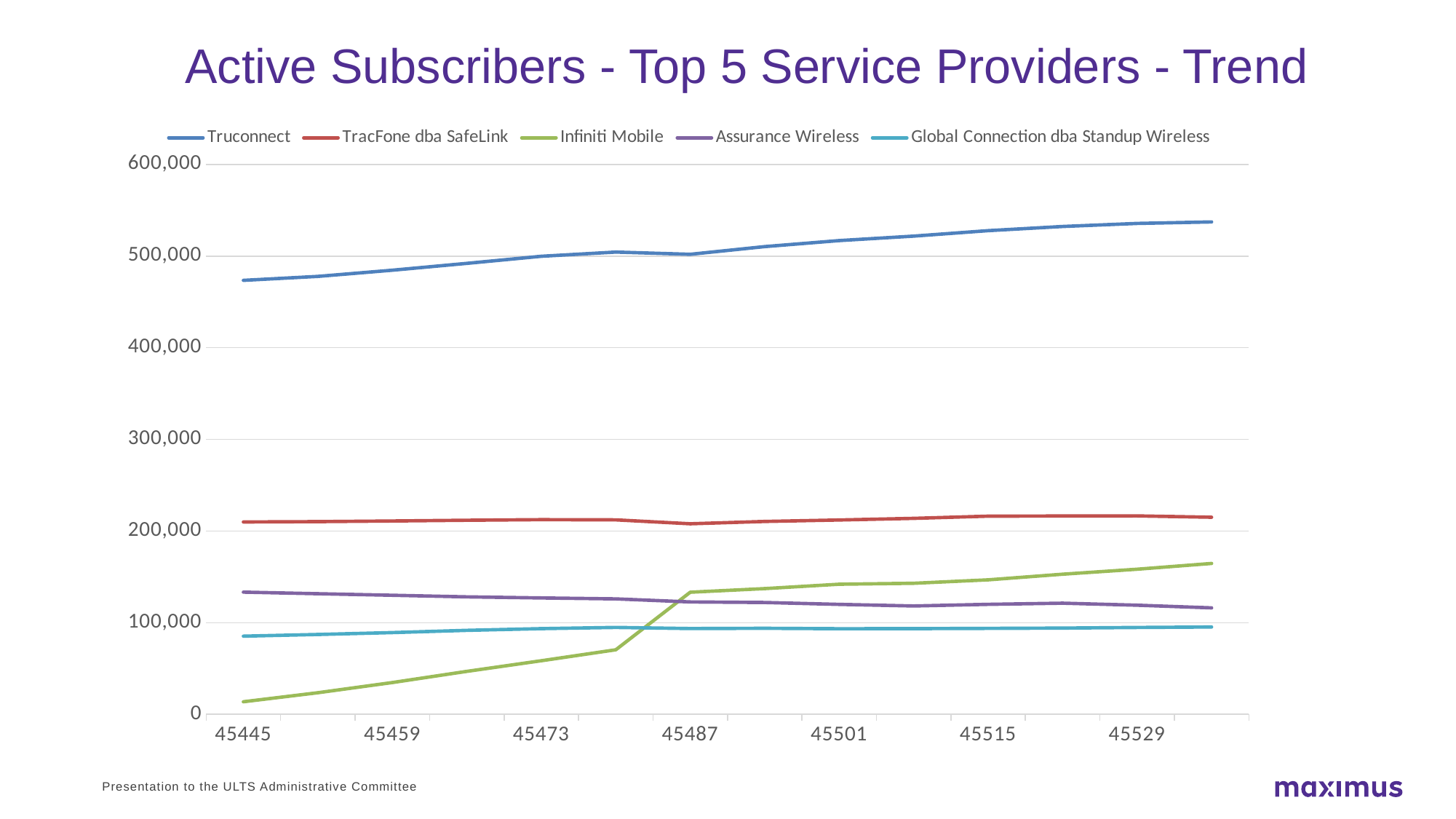
At the last point on the chart, which is larger: Infiniti Mobile or Assurance Wireless? Infiniti Mobile How many series does the legend list? 5 At 45445, which is larger: Assurance Wireless or Global Connection dba Standup Wireless? Assurance Wireless Which service provider has the lowest number of active subscribers at the first point (45445)? Infiniti Mobile Is the value for Infiniti Mobile at 45445 greater or less than 100,000? less Does the Assurance Wireless line generally rise or fall across the x axis? fall Is the value for Truconnect at 45445 greater or less than 400,000? greater What is the title of the chart? Active Subscribers - Top 5 Service Providers - Trend Does the Truconnect line generally rise or fall across the x axis? rise What kind of chart is shown on the slide? line chart Which service provider has the highest number of active subscribers throughout the period? Truconnect Is the value for TracFone dba SafeLink at 45487 greater or less than 300,000? less